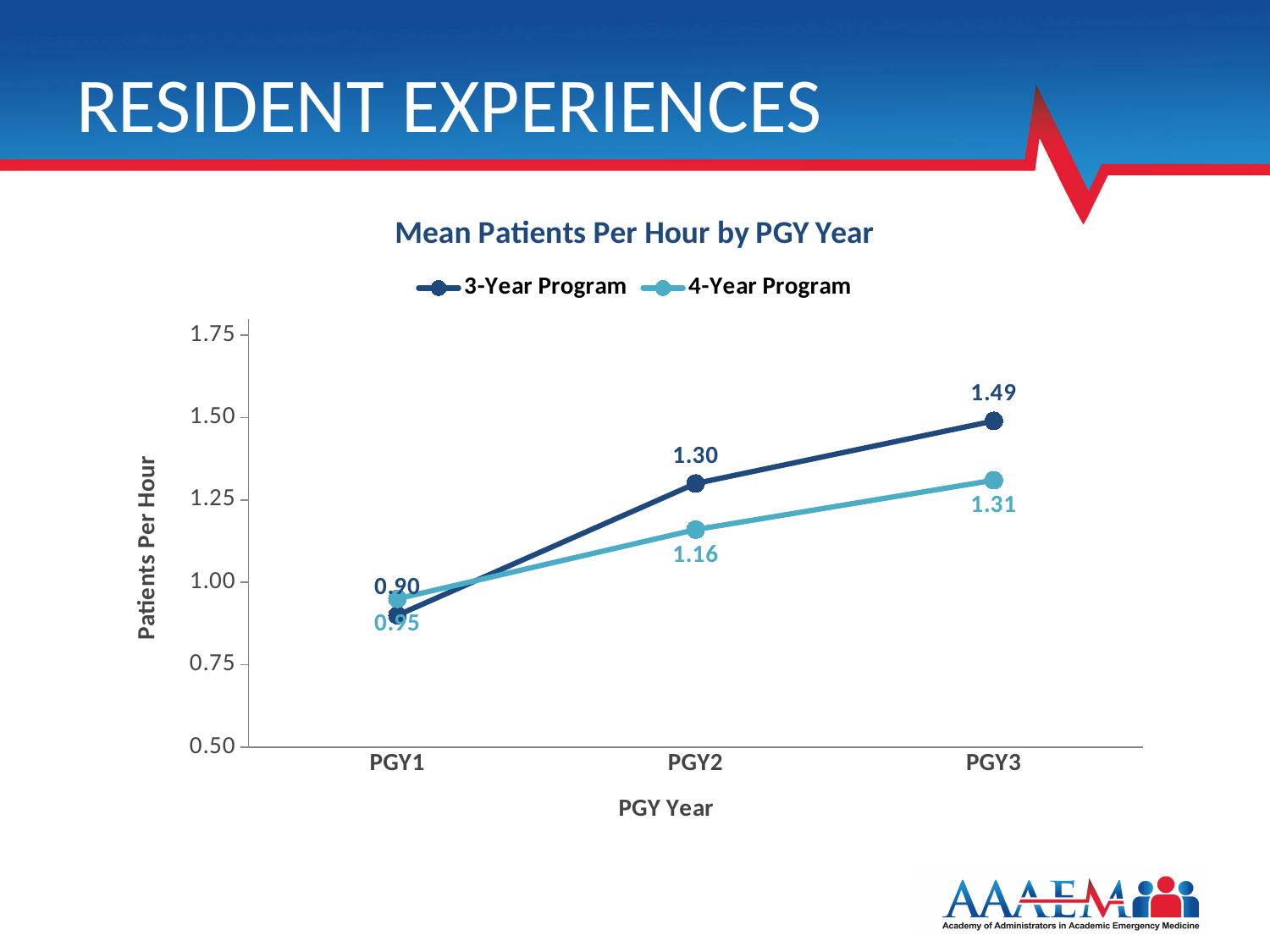
At which PGY year is the 3-Year Program value highest? PGY3 What is the difference between the 3-Year Program and 4-Year Program values at PGY3? 0.18 At which PGY year is the 4-Year Program value lowest? PGY1 What is the mean patients per hour for the 3-Year Program at PGY3? 1.49 What kind of chart is shown on the slide? Line chart Do the 4-Year Program values rise or fall from PGY1 to PGY3? Rise What is the mean patients per hour for the 4-Year Program at PGY2? 1.16 How many PGY years are shown on the x axis? 3 At PGY2, which program has the higher mean patients per hour? 3-Year Program How many series does the legend list? 2 What is the mean patients per hour for the 3-Year Program at PGY2? 1.30 What is the mean patients per hour for the 4-Year Program at PGY3? 1.31